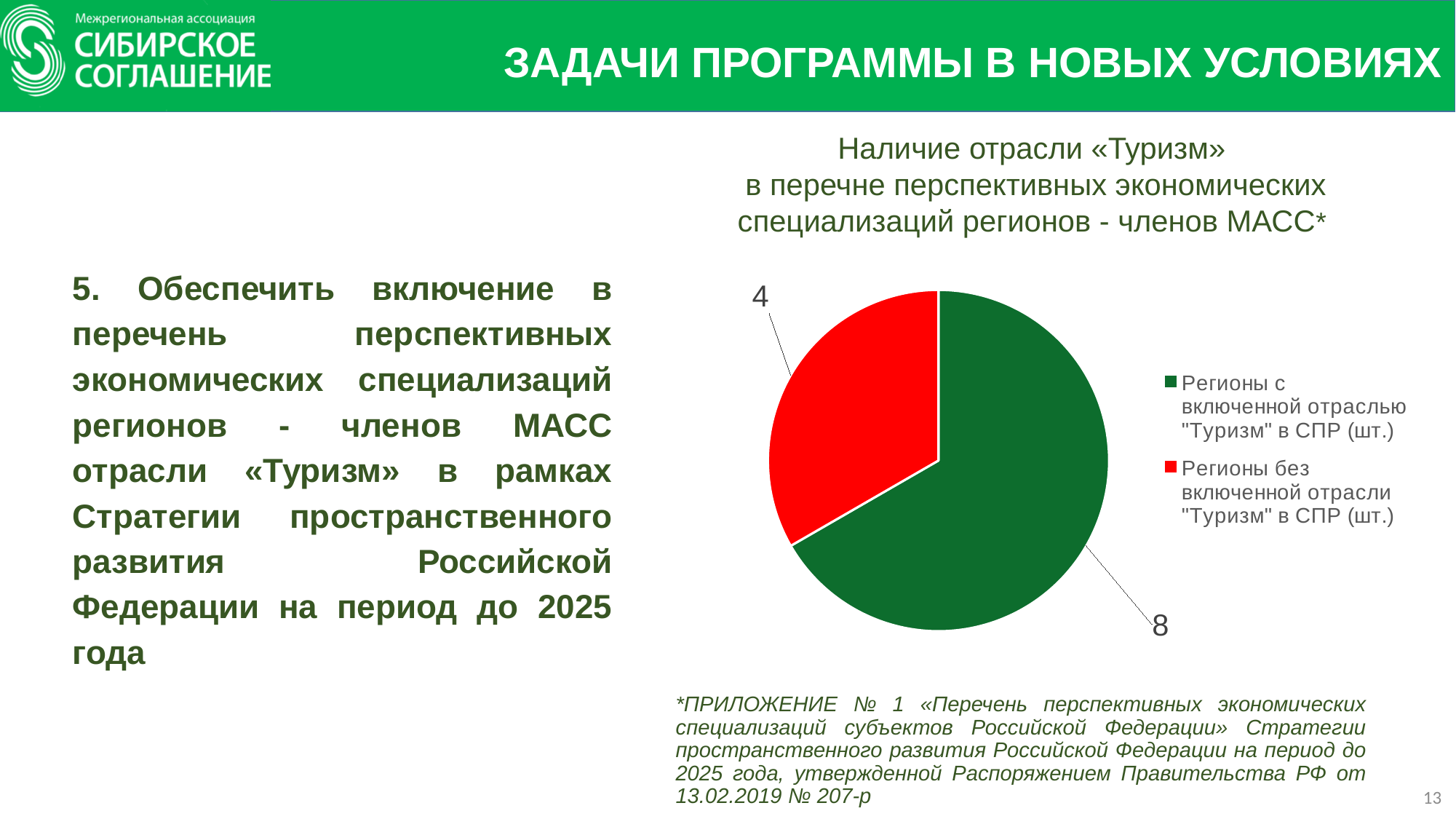
Is the number of regions with the "Туризм" industry included larger or smaller than the number without it? Larger How many regions do not have the "Туризм" industry included in the СПР, according to the pie chart? 4 How many slices does the pie chart have? 2 Which category has the larger slice in the pie chart? Регионы с включенной отраслью "Туризм" в СПР (шт.) How many regions have the "Туризм" industry included in the СПР, according to the pie chart? 8 What is the difference between the number of regions with the "Туризм" industry included and those without it? 4 What colour is the slice for regions without the "Туризм" industry included in the СПР? Red Which category has the smaller slice in the pie chart? Регионы без включенной отрасли "Туризм" в СПР (шт.) What is the total number of regions represented in the pie chart? 12 What kind of chart is shown on the slide? Pie chart How many entries does the legend of the pie chart list? 2